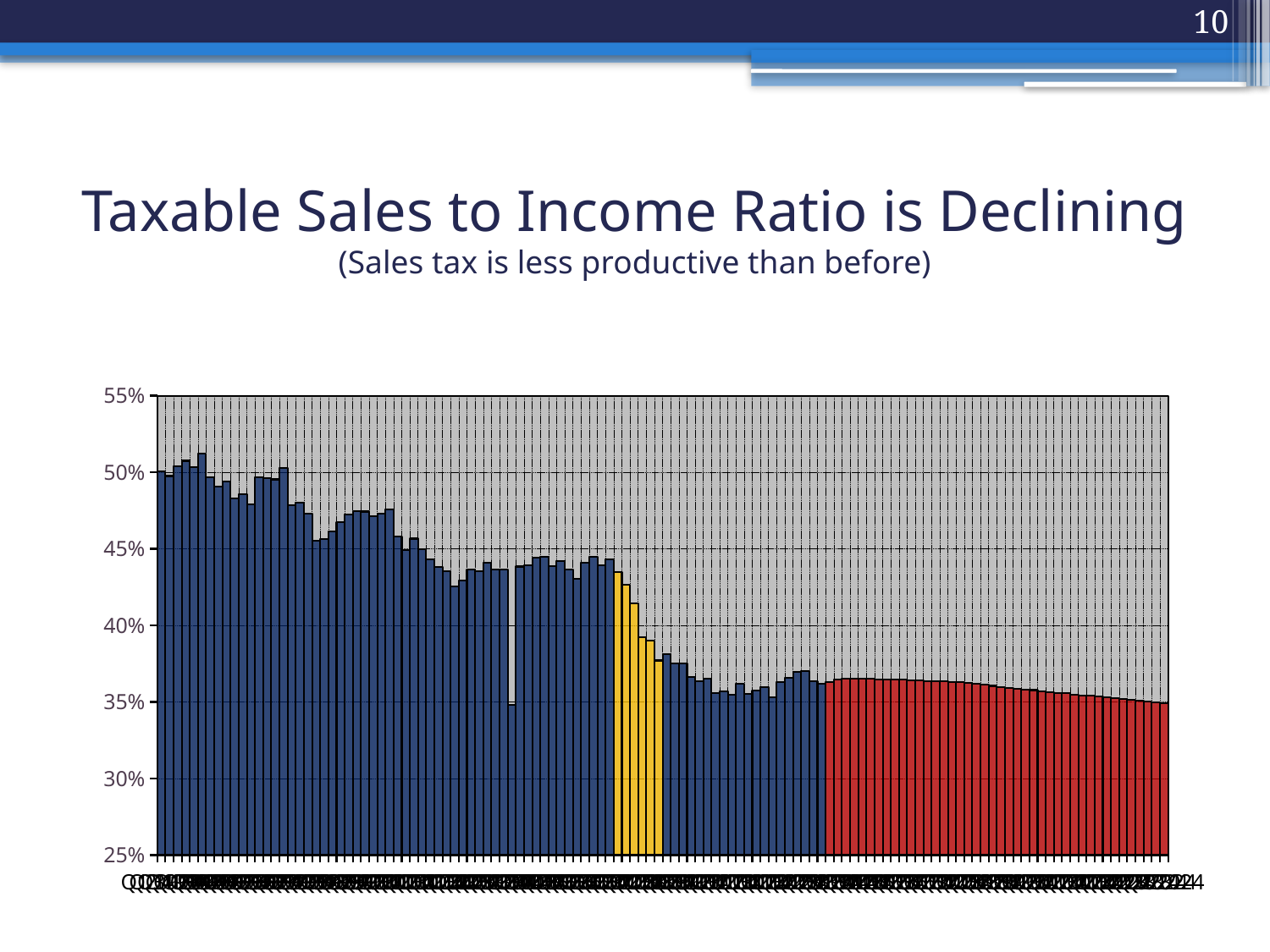
Which colour group of bars contains the highest bar on the chart? blue Is the value of the leftmost bar greater or less than 45%? greater What are the lowest and highest values shown on the y axis? 25% and 55% Which is larger, the leftmost bar or the rightmost bar? the leftmost bar Is the value of the leftmost bar greater or less than 55%? less Is the value of the rightmost bar greater or less than 40%? less Overall, do the values rise or fall from left to right along the x axis? fall What kind of chart is shown on the slide? bar chart How many different bar colours are used in the chart? 3